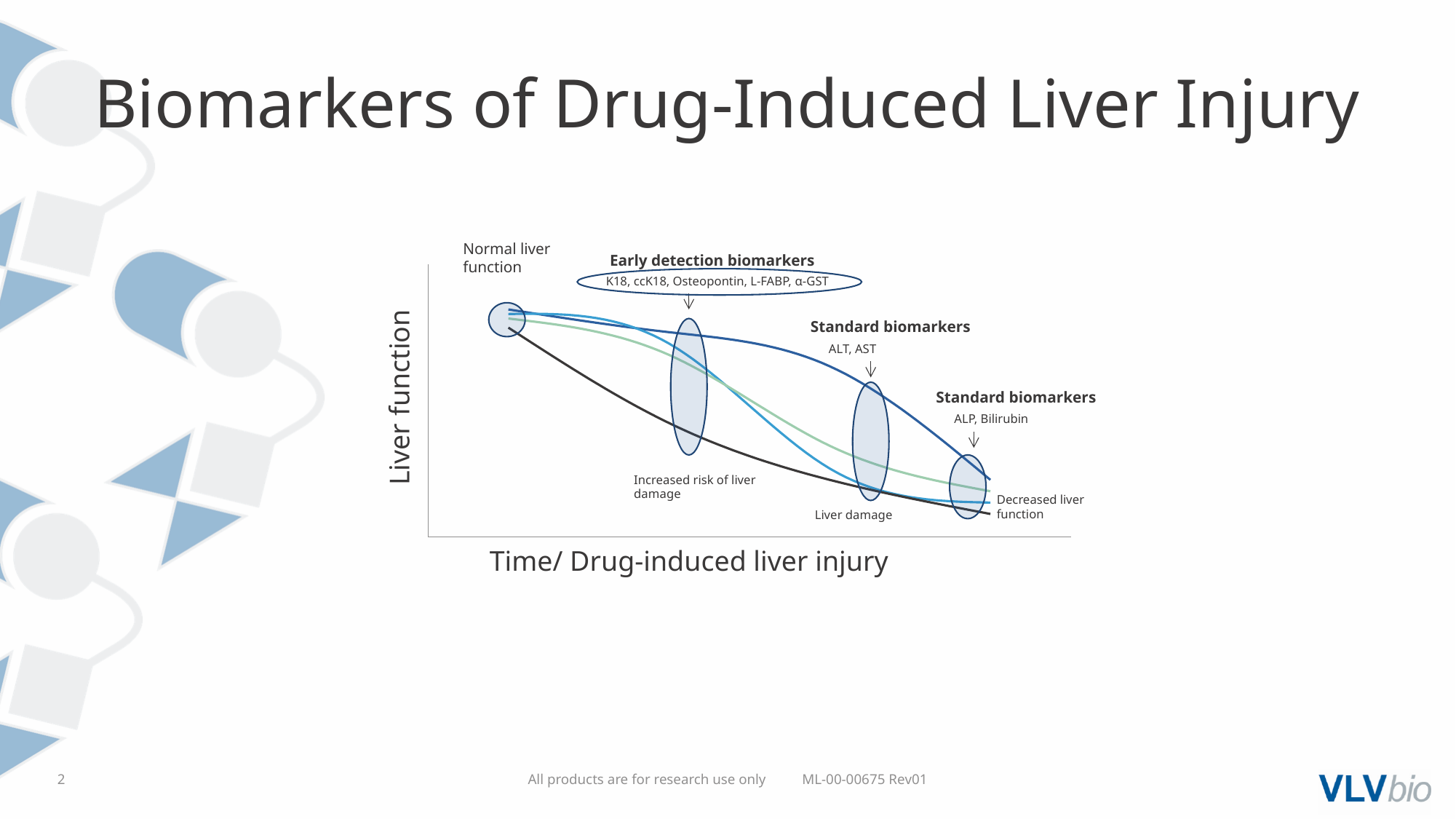
What is the label of the x axis? Time/ Drug-induced liver injury What does the end of the curves at the bottom right represent? Decreased liver function Which biomarkers are listed as early detection biomarkers? K18, ccK18, Osteopontin, L-FABP, α-GST Which standard biomarkers are indicated at the middle highlighted region of the chart? ALT, AST How many highlighted biomarker detection regions are marked along the curves? 3 What label is placed below the first highlighted region on the chart? Increased risk of liver damage Which group of biomarkers is detected earliest along the time axis? Early detection biomarkers What is the label of the y axis? Liver function Do the curves rise or fall along the x axis? Fall What kind of chart is shown on the slide? Line chart Which standard biomarkers are indicated at the rightmost highlighted region of the chart? ALP, Bilirubin What does the starting point of the curves at the top left represent? Normal liver function